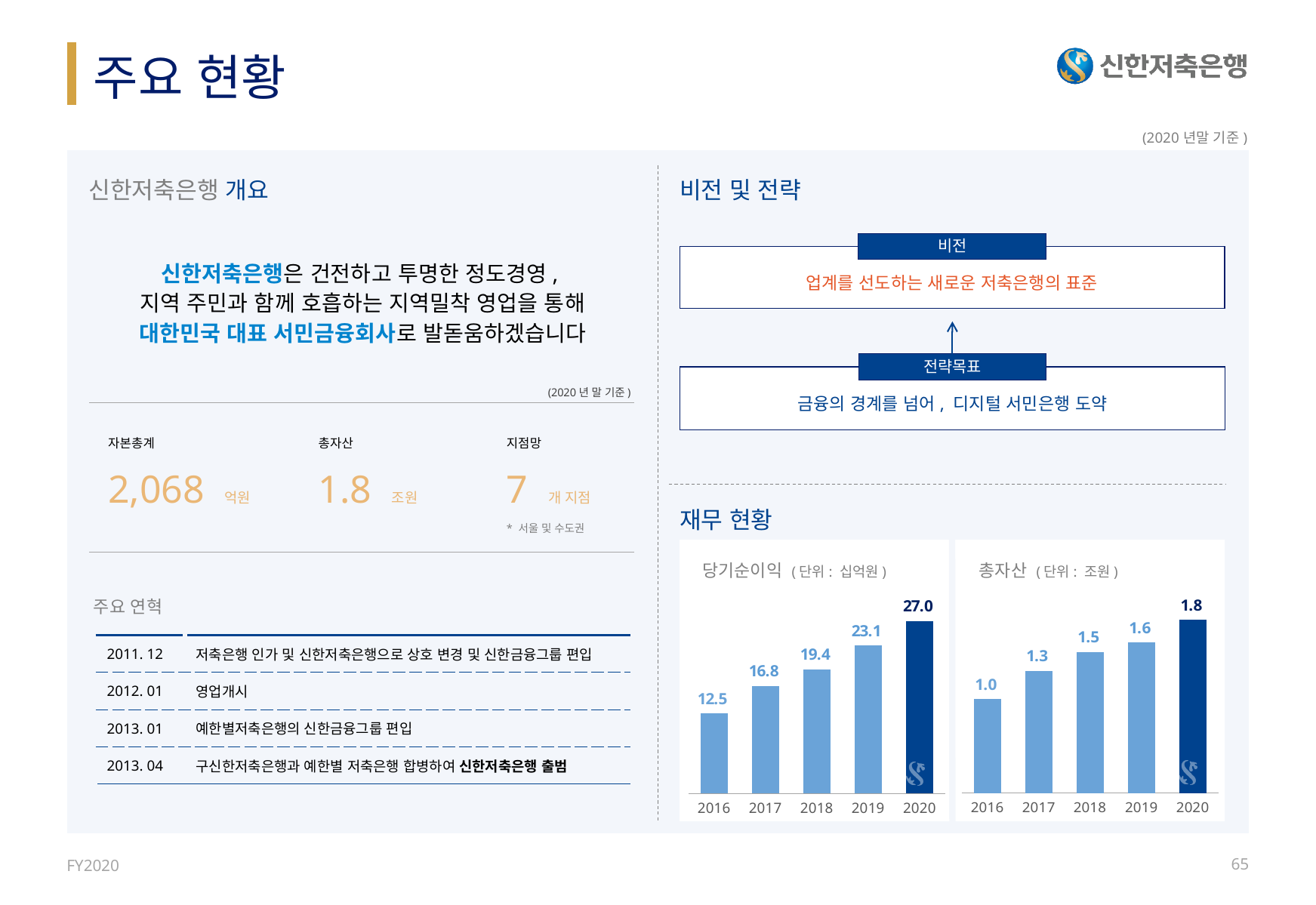
What kind of chart is the 당기순이익 chart? Bar chart How many years are shown in the 총자산 chart? 5 In the 당기순이익 chart, which year has the highest value? 2020 In the 총자산 chart, what is the difference between the 2020 and 2016 values? 0.8 In the 당기순이익 chart, which is larger, the value for 2017 or the value for 2018? 2018 In the 총자산 chart, what is the value for 2018? 1.5 What unit is stated for the 당기순이익 chart? 십억원 In the 당기순이익 chart, what is the value for 2016? 12.5 In the 당기순이익 chart, what is the difference between the 2020 and 2019 values? 3.9 In the 당기순이익 chart, what is the value for 2020? 27.0 In the 당기순이익 chart, do the values rise or fall from 2016 to 2020? Rise In the 총자산 chart, which year has the lowest value? 2016